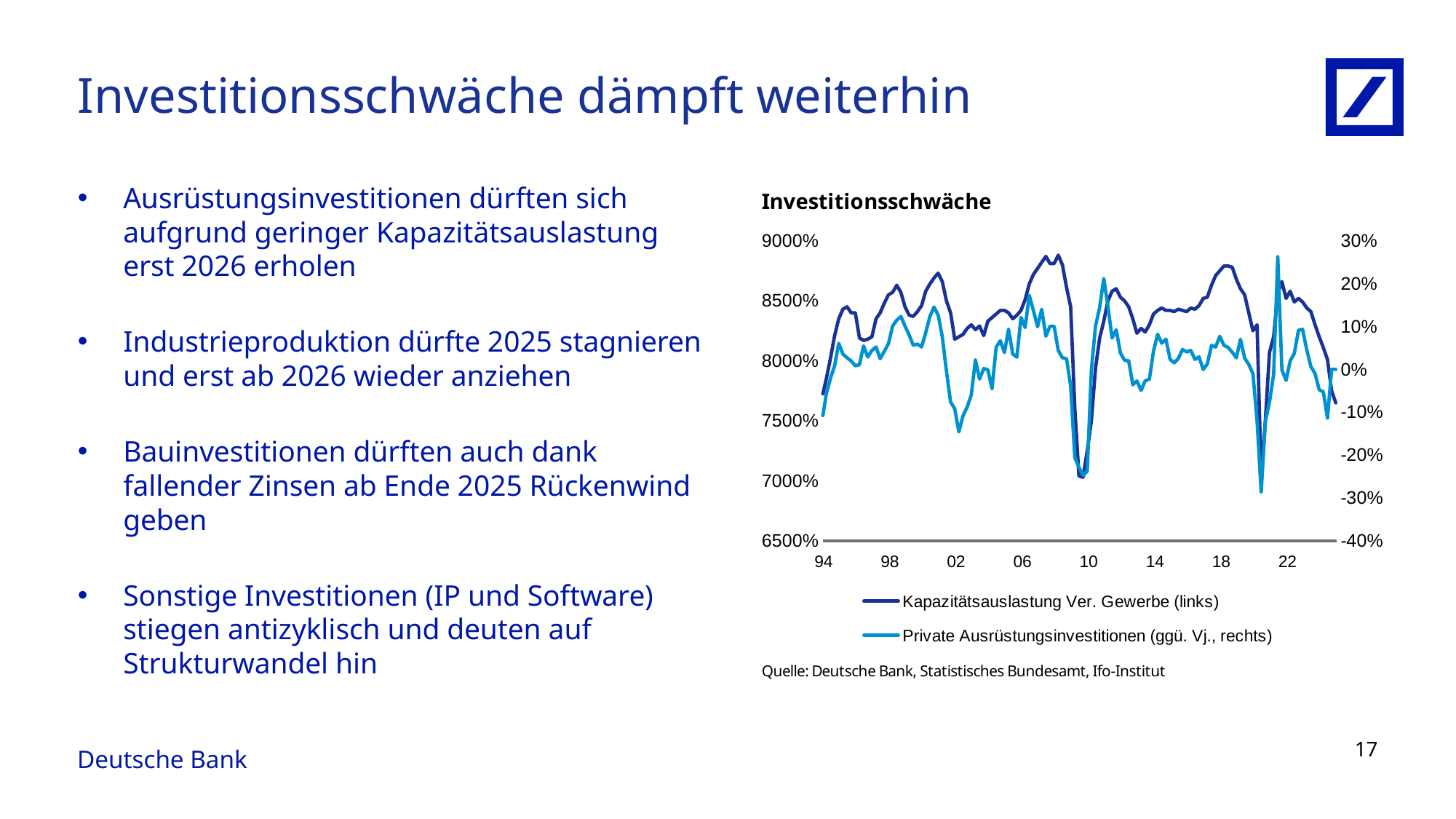
What kind of chart is shown on the slide? line chart How many series does the legend of the chart list? 2 Which series in the chart is plotted against the right axis according to the legend? Private Ausrüstungsinvestitionen (ggü. Vj., rechts) Does the Private Ausrüstungsinvestitionen line rise or fall from its 2021 peak to the end of the series? fall Is the value of Kapazitätsauslastung Ver. Gewerbe at its low point around 2009 greater or less than 7500%? less Is the value of Kapazitätsauslastung Ver. Gewerbe at the start of the series in 1994 greater or less than 8000%? less Does the Kapazitätsauslastung Ver. Gewerbe line rise or fall from 2022 to the end of the series? fall Is the value of Private Ausrüstungsinvestitionen at its low point around 2020 greater or less than -20%? less What is the title of the chart? Investitionsschwäche Does the Kapazitätsauslastung Ver. Gewerbe line rise or fall between 2009 and 2011? rise